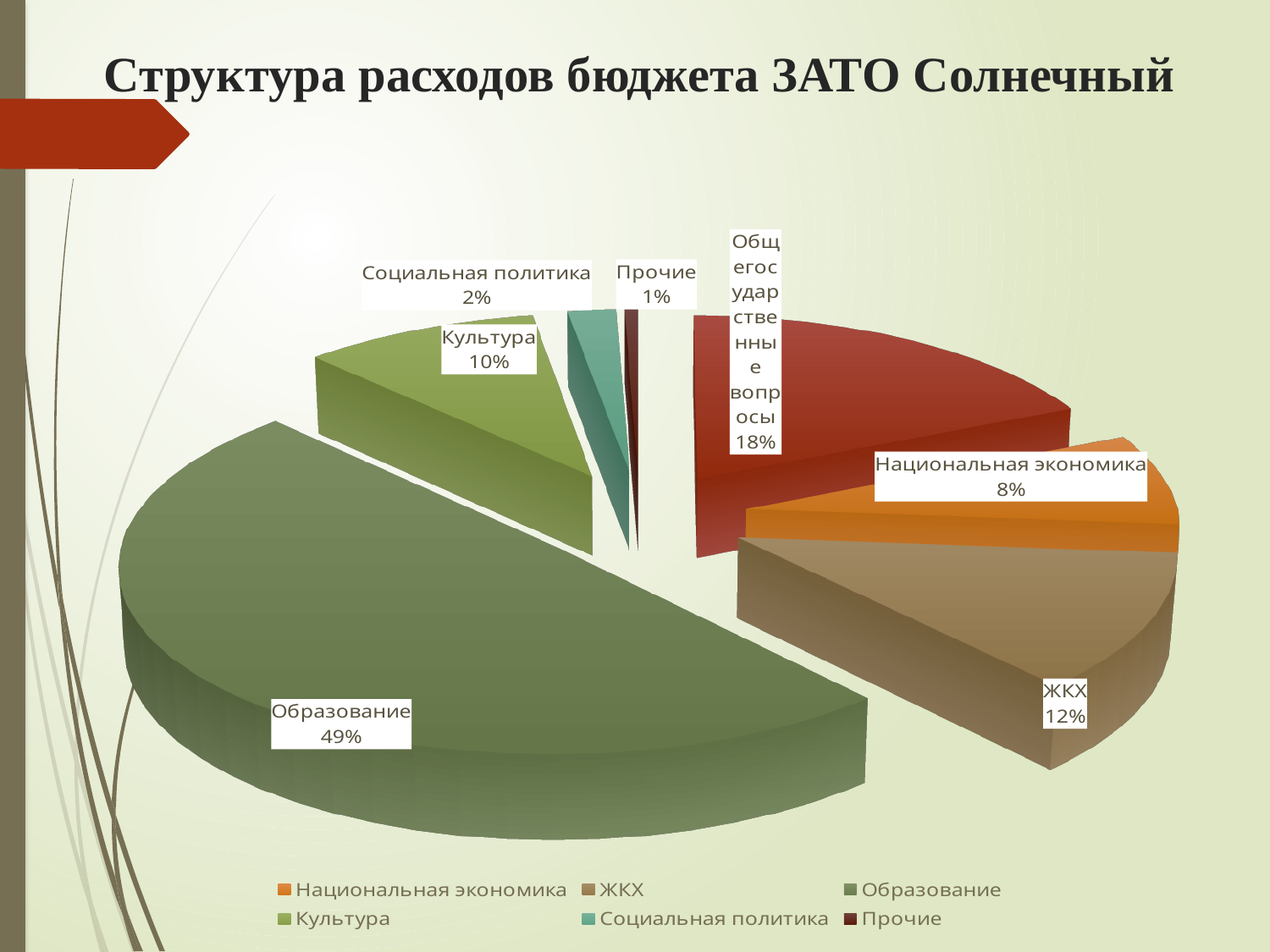
Which category has the smallest share of the pie? Прочие What is the difference in percentage points between Образование and Общегосударственные вопросы? 31 What kind of chart is shown on the slide? pie chart What percentage is shown for Национальная экономика? 8% What is the title of the chart? Структура расходов бюджета ЗАТО Солнечный Which is larger, the share for ЖКХ or the share for Культура? ЖКХ What percentage is shown for ЖКХ? 12% What percentage is shown for Культура? 10% How many slices does the pie chart have? 7 What share of the budget expenditure goes to Образование? 49% What percentage is shown for Общегосударственные вопросы? 18% Which category has the largest share of the pie? Образование